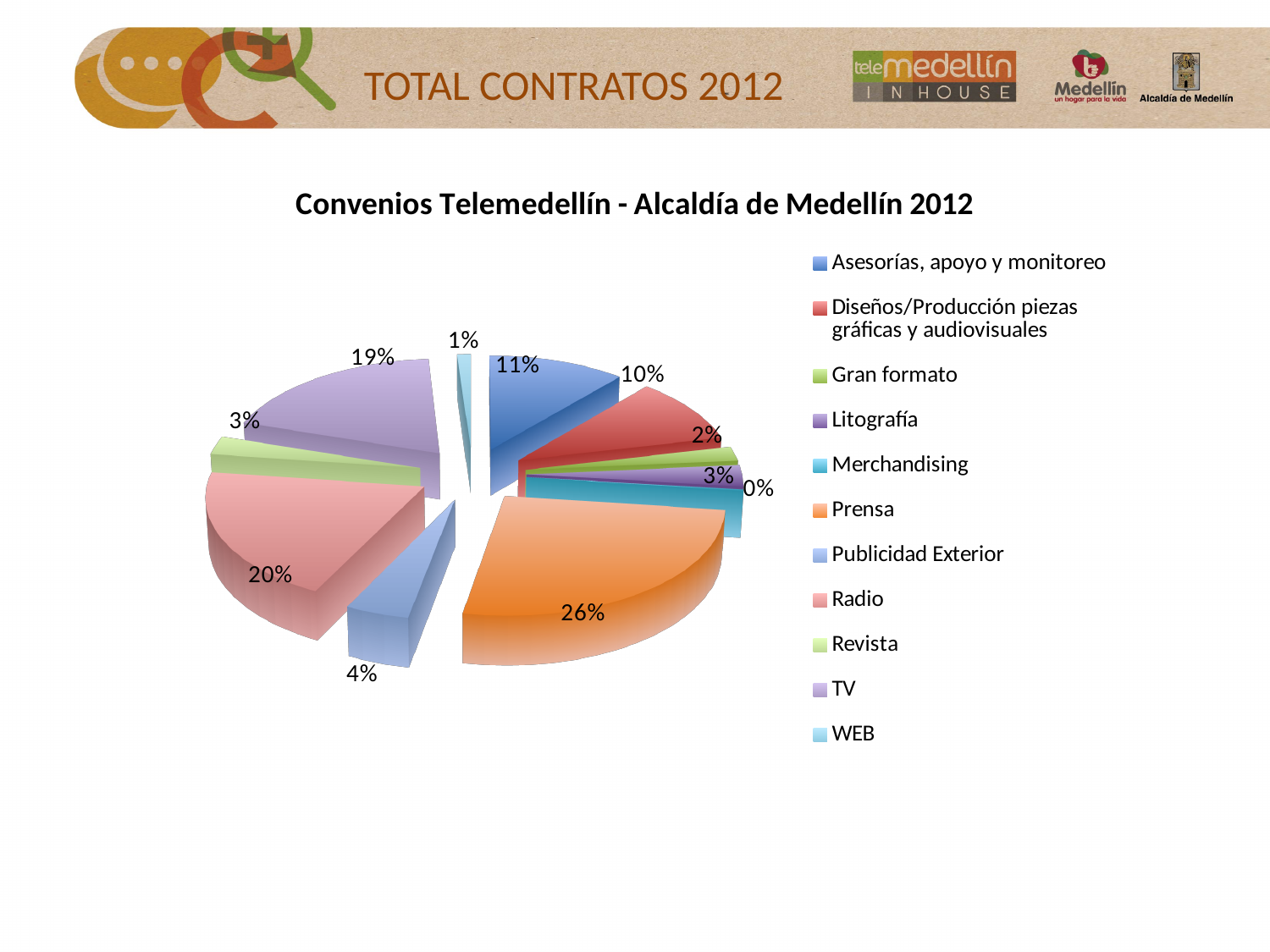
Which category has the smallest share of the pie? Merchandising What is the title of the chart? Convenios Telemedellín - Alcaldía de Medellín 2012 What share of the pie does TV represent? 19% What is the value shown for Publicidad Exterior? 4% What share of the pie does Radio represent? 20% What type of chart is shown on the slide? Pie chart What is the value shown for Asesorías, apoyo y monitoreo? 11% Which has a larger share, Diseños/Producción piezas gráficas y audiovisuales or Publicidad Exterior? Diseños/Producción piezas gráficas y audiovisuales How many categories does the legend list? 11 What is the difference between the shares of Prensa and Radio? 6% What share of the pie does Prensa represent? 26% Which category has the largest share of the pie? Prensa